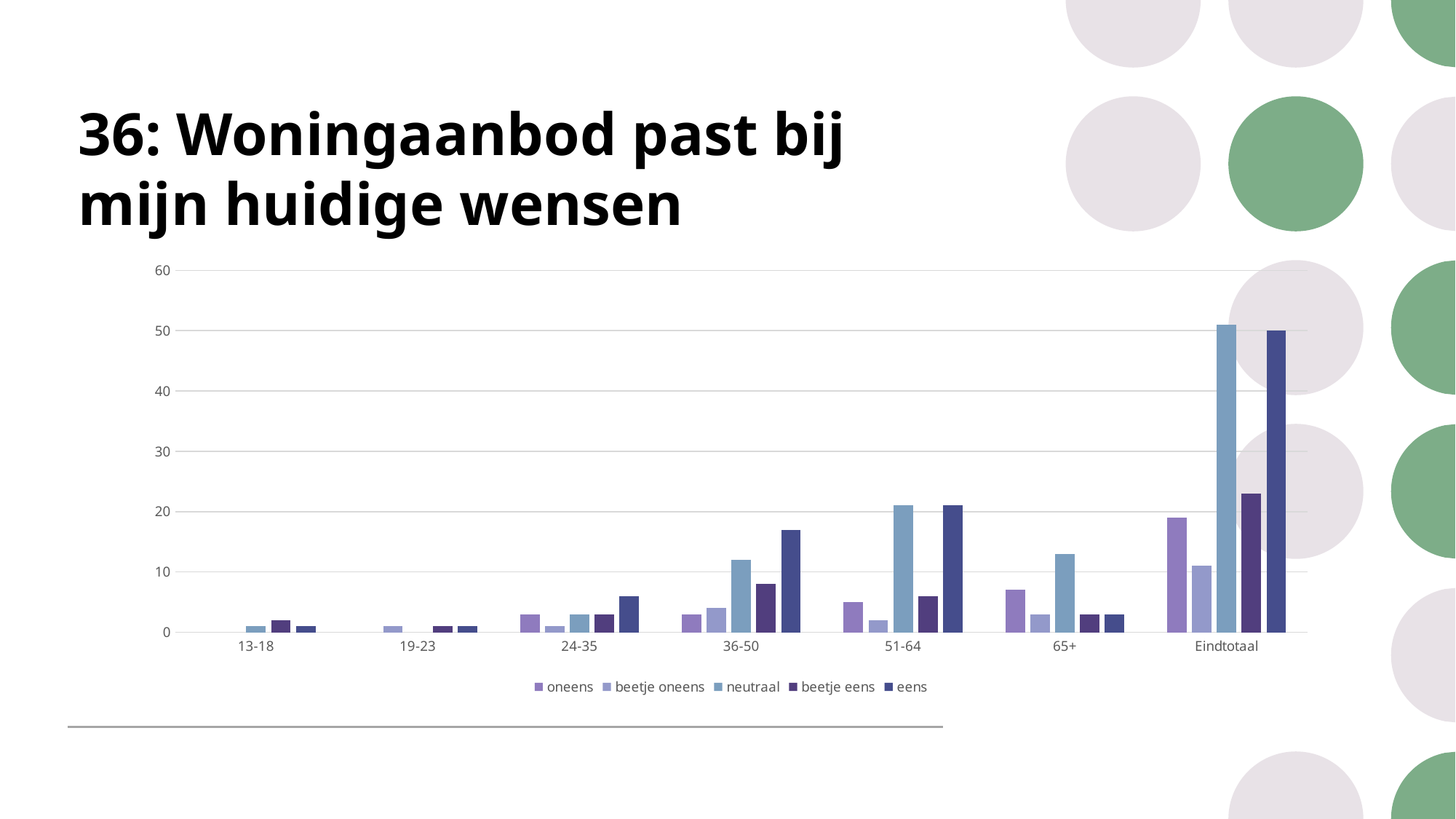
What is the title of the slide containing the chart? 36: Woningaanbod past bij mijn huidige wensen How many series does the legend list? 5 Is the value for eens in the 36-50 category greater or less than 20? less In which category is the neutraal bar the highest? Eindtotaal Is the value for neutraal in the 65+ category greater or less than 10? greater In the 36-50 category, which is larger: neutraal or beetje eens? neutraal What kind of chart is shown on the slide? bar chart Which series has the highest bar in the 36-50 category? eens Which series has the highest bar in the 65+ category? neutraal How many categories are shown on the x axis? 7 In the Eindtotaal category, which is larger: oneens or beetje oneens? oneens Is the value for beetje eens in the Eindtotaal category greater or less than 20? greater